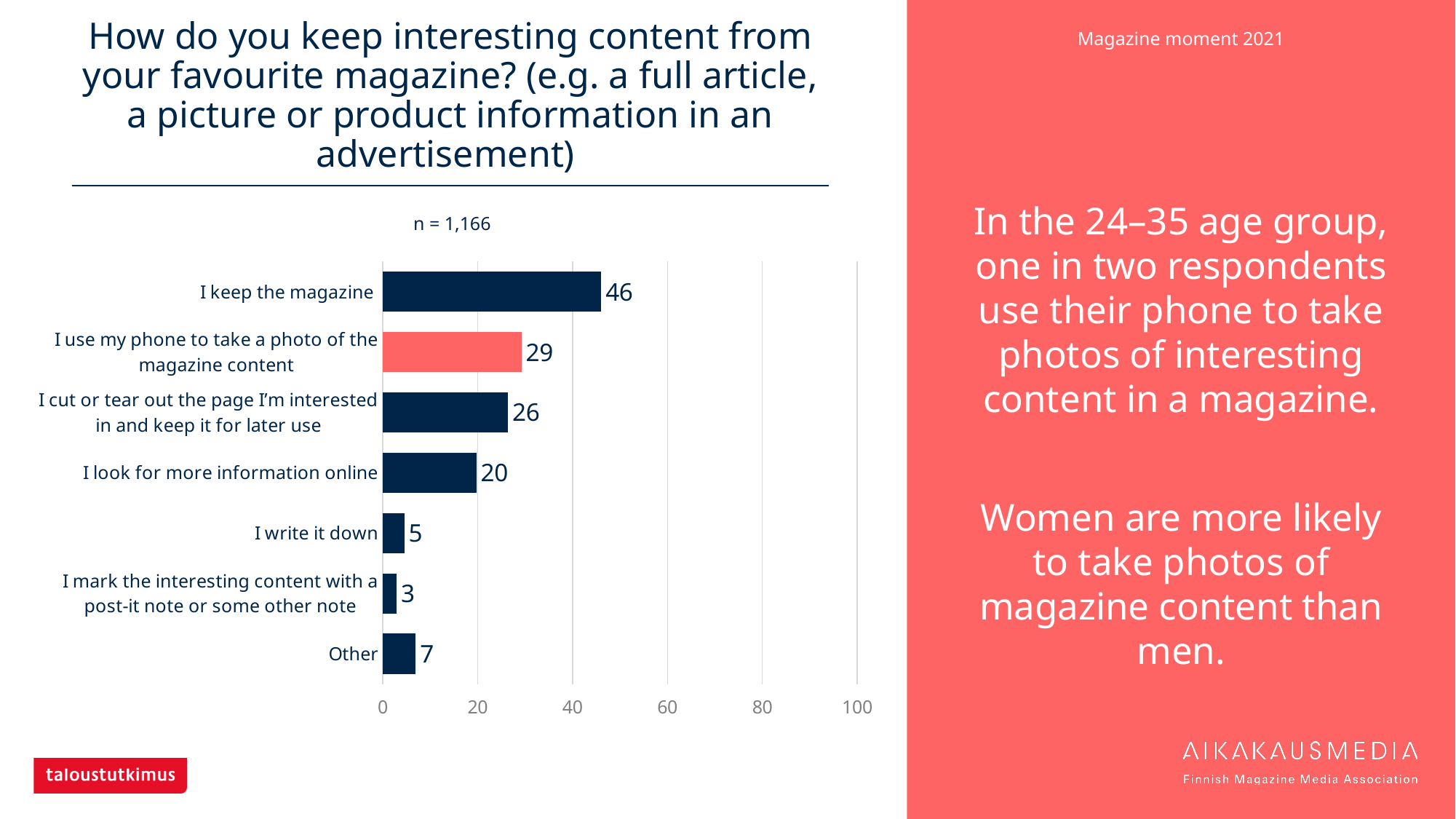
What is the value for "I look for more information online"? 20 Is the value for "I cut or tear out the page I'm interested in and keep it for later use" greater or less than 40? less What is the sample size (n) shown above the chart? n = 1,166 How many categories are shown in the chart? 7 What is the value for "I use my phone to take a photo of the magazine content"? 29 What kind of chart is shown on the slide? bar chart Which is larger: "I write it down" or "Other"? Other What is the value for "I keep the magazine"? 46 Which category has the highest value? I keep the magazine Which category has the lowest value? I mark the interesting content with a post-it note or some other note What is the difference between "I keep the magazine" and "I use my phone to take a photo of the magazine content"? 17 What is the value for "Other"? 7